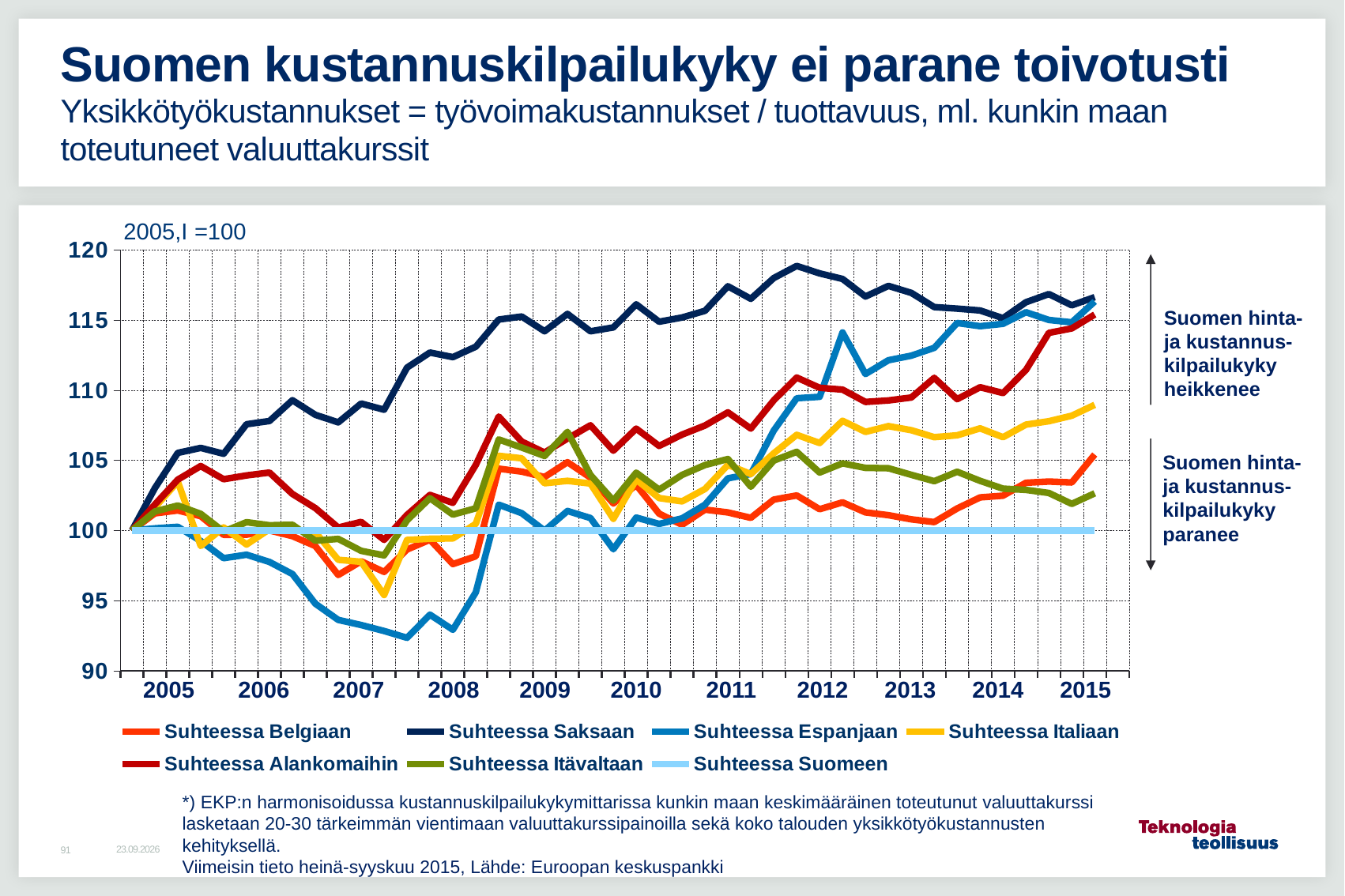
What kind of chart is shown on the slide? line chart Does the 'Suhteessa Saksaan' line rise or fall from 2005 to 2012? rise Is the value for 'Suhteessa Saksaan' in 2012 greater or less than 115? greater What is the index base stated above the chart? 2005,I =100 How many series does the legend list? 7 How many year labels are shown on the x axis? 11 What value does the 'Suhteessa Suomeen' line hold across the whole period? 100 Is the value for 'Suhteessa Espanjaan' in 2007 greater or less than 95? less In 2014, which is larger: 'Suhteessa Alankomaihin' or 'Suhteessa Belgiaan'? Suhteessa Alankomaihin Which series is highest in 2012? Suhteessa Saksaan Which series is lowest in 2007? Suhteessa Espanjaan Is the value for 'Suhteessa Belgiaan' in 2013 greater or less than 105? less